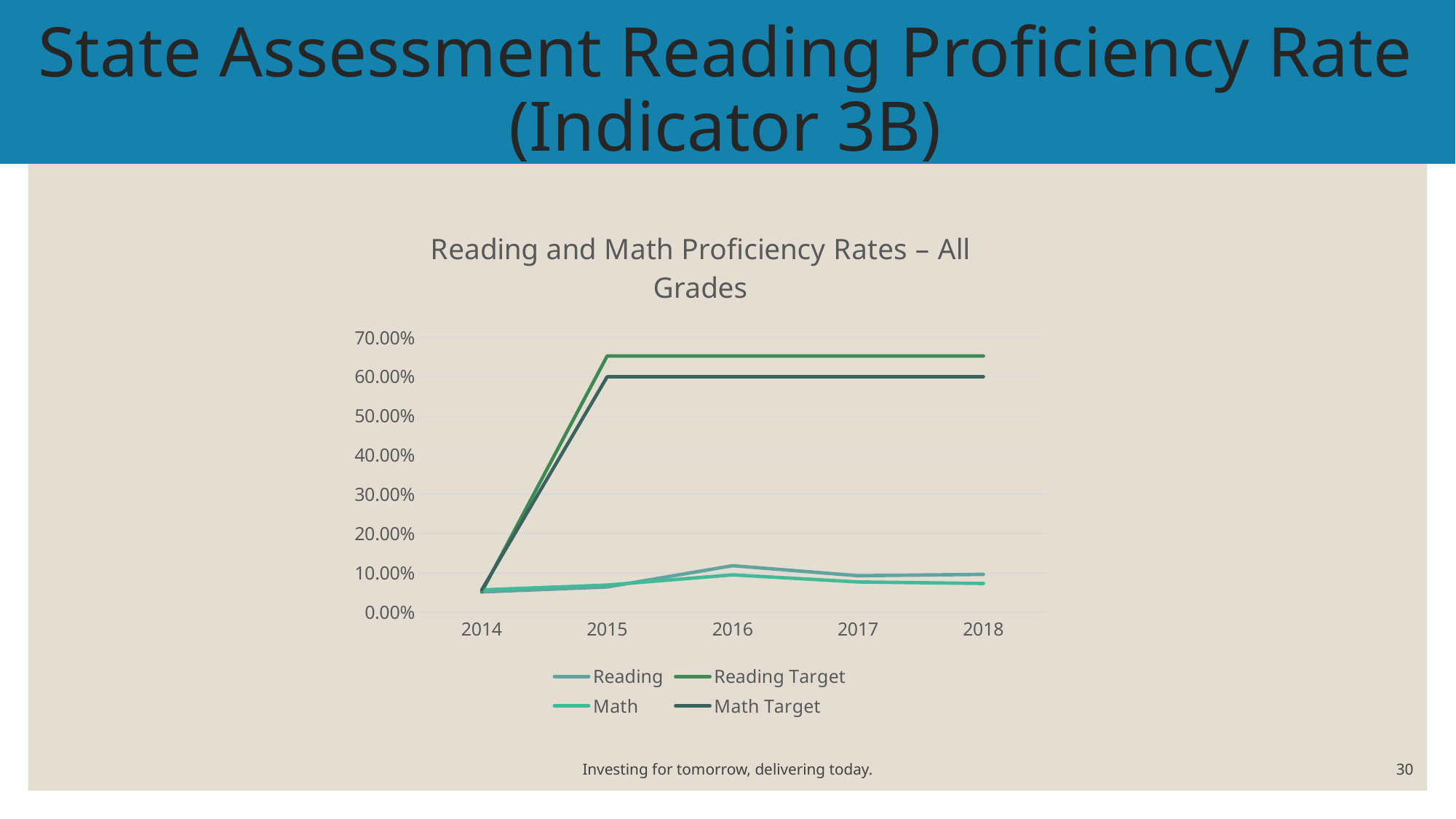
What is the title of the chart? Reading and Math Proficiency Rates – All Grades Is the Reading Target value for 2017 greater or less than 60.00%? greater Does the Reading Target line rise or fall from 2014 to 2015? Rise In 2017, which is larger: Reading Target or Math Target? Reading Target How many years are shown on the x axis? 5 What kind of chart is shown on the slide? Line chart Which series has the highest value in 2018? Reading Target In 2016, which is larger: Reading or Math? Reading Is the Math value for 2018 greater or less than 10.00%? less Is the Reading value for 2016 greater or less than 20.00%? less How many series does the legend list? 4 What is the Math Target value in 2016? 60.00%